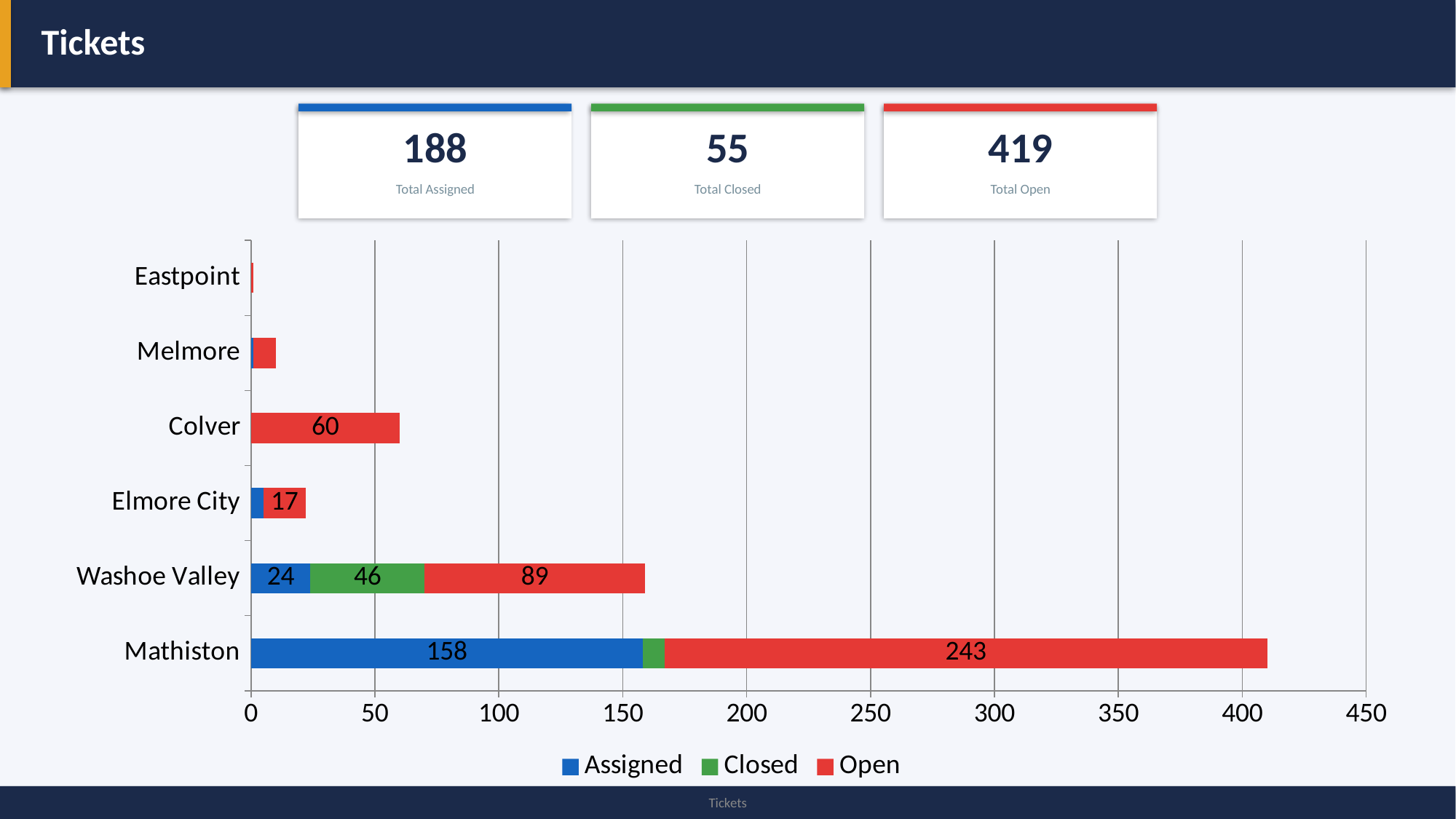
Which has a larger Open value, Colver or Elmore City? Colver What is the difference between the Open and Assigned values for Mathiston? 85 Is the total bar length for Mathiston greater or less than 400? greater Which location has the shortest total bar? Eastpoint What is the total of the stacked bar for Washoe Valley? 159 What is the Open value for Colver? 60 How many locations are shown on the chart? 6 What is the Assigned value for Mathiston? 158 Which location has the longest total bar? Mathiston How many series does the legend list? 3 What is the Closed value for Washoe Valley? 46 What kind of chart is shown on the slide? Stacked bar chart